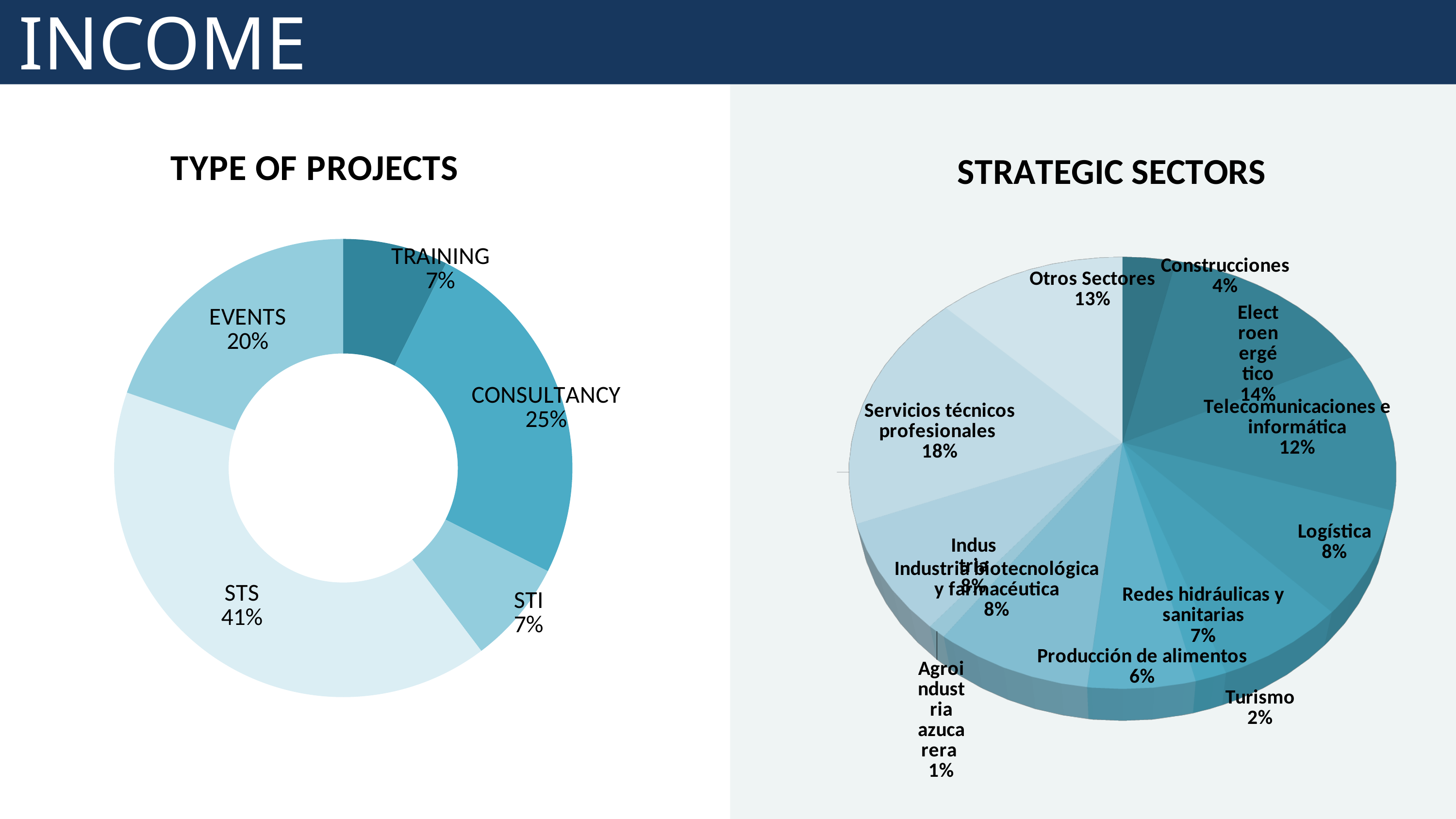
In the STRATEGIC SECTORS chart, what percentage is shown for Servicios técnicos profesionales? 18% In the TYPE OF PROJECTS chart, what percentage is shown for CONSULTANCY? 25% In the STRATEGIC SECTORS chart, which is larger: Electroenergético or Telecomunicaciones e informática? Electroenergético In the STRATEGIC SECTORS chart, which sector has the smallest share? Agroindustria azucarera In the TYPE OF PROJECTS chart, how many categories are shown? 5 In the STRATEGIC SECTORS chart, which sector has the largest share? Servicios técnicos profesionales What kind of chart is the TYPE OF PROJECTS chart? Donut (pie) chart In the TYPE OF PROJECTS chart, what is the difference between the EVENTS share and the TRAINING share? 13% In the STRATEGIC SECTORS chart, what is the difference between Otros Sectores and Construcciones? 9% In the TYPE OF PROJECTS chart, what share of income comes from STS? 41% In the TYPE OF PROJECTS chart, which type of project has the largest share? STS In the STRATEGIC SECTORS chart, what percentage is shown for Turismo? 2%